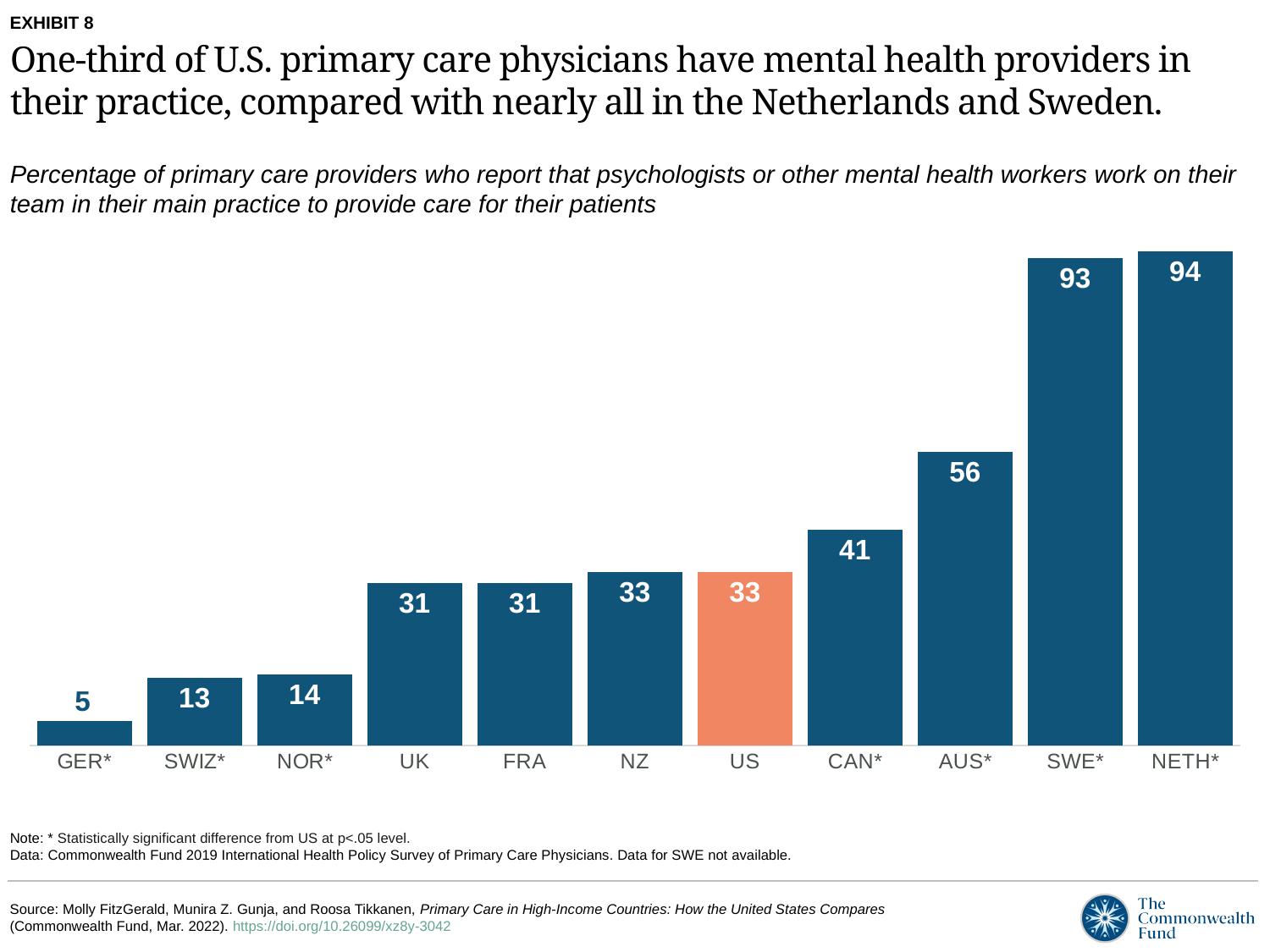
What is the value for AUS*? 56 Which country has the highest value? NETH* What is the value for the US? 33 What kind of chart is shown on the slide? Bar chart Which country has the lowest value? GER* What is the difference between the values for NETH* and the US? 61 Which is larger, the value for CAN* or the value for NZ? CAN* What is the difference between the values for CAN* and SWIZ*? 28 How many countries are shown in the chart? 11 Which country's bar is highlighted in orange? US Do the values rise or fall from left to right across the chart? Rise What is the value for GER*? 5